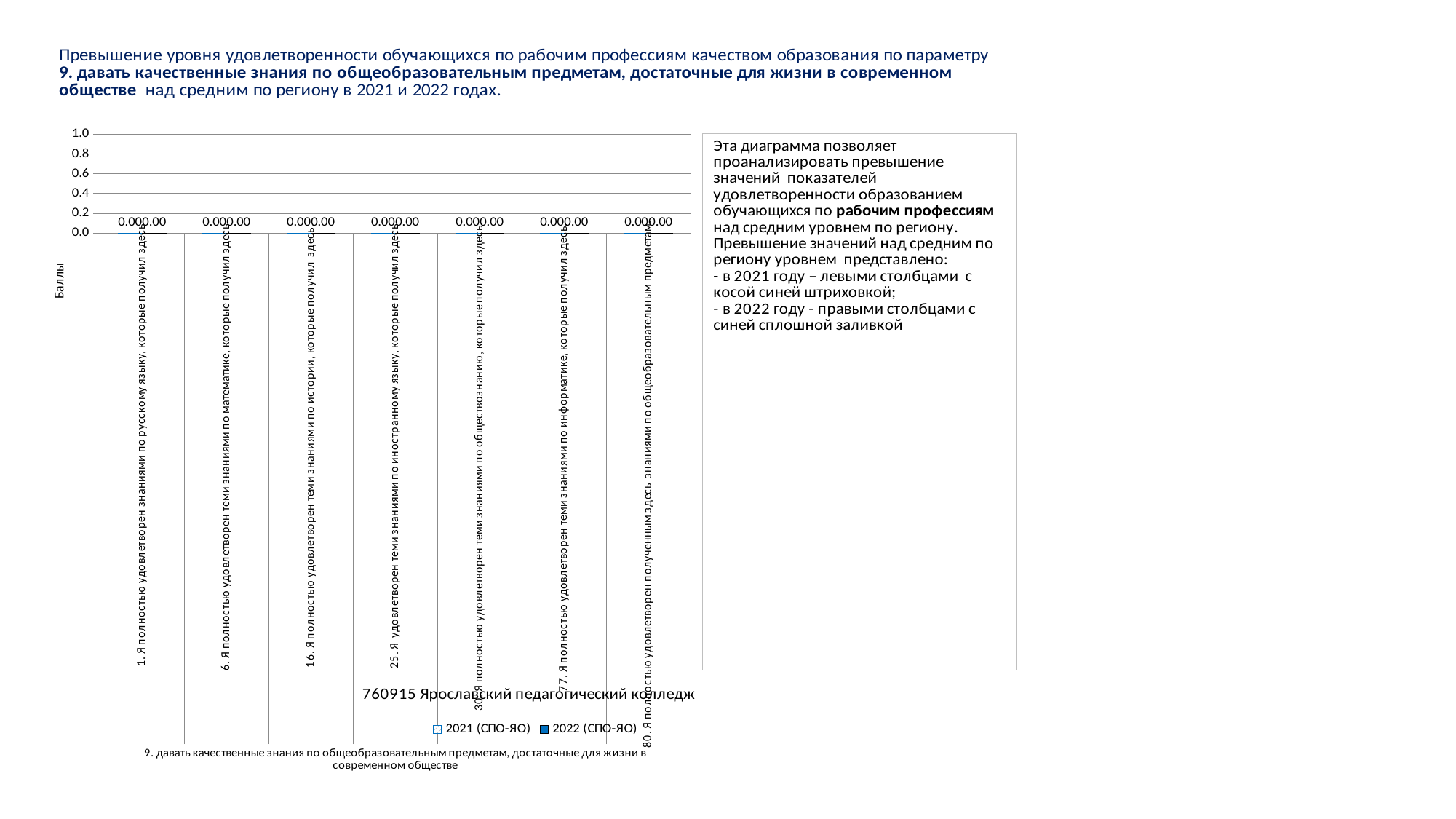
What is the title of the vertical axis of the chart? Баллы How many categories are plotted along the x axis of the chart? 7 What is the value of the 2022 (СПО-ЯО) series for category "6. Я полностью удовлетворен теми знаниями по математике, которые получил здесь"? 0.00 What is the highest value shown on the vertical axis of the chart? 1.0 What is the value of the 2021 (СПО-ЯО) series for category "1. Я полностью удовлетворен знаниями по русскому языку, которые получил здесь"? 0.00 Is the 2022 (СПО-ЯО) value for category "77. Я полностью удовлетворен теми знаниями по информатике, которые получил здесь" greater or less than 0.2? less What is the value of the 2021 (СПО-ЯО) series for category "16. Я полностью удовлетворен теми знаниями по истории, которые получил здесь"? 0.00 What kind of chart is shown on the slide? bar chart Do the values of the 2021 (СПО-ЯО) series rise, fall, or stay the same across the categories on the x axis? stay the same What is the difference between the 2021 (СПО-ЯО) and 2022 (СПО-ЯО) values for category "25. Я удовлетворен теми знаниями по иностранному языку, которые получил здесь"? 0.00 How many series does the chart legend list? 2 What are the two series named in the chart legend? 2021 (СПО-ЯО) and 2022 (СПО-ЯО)